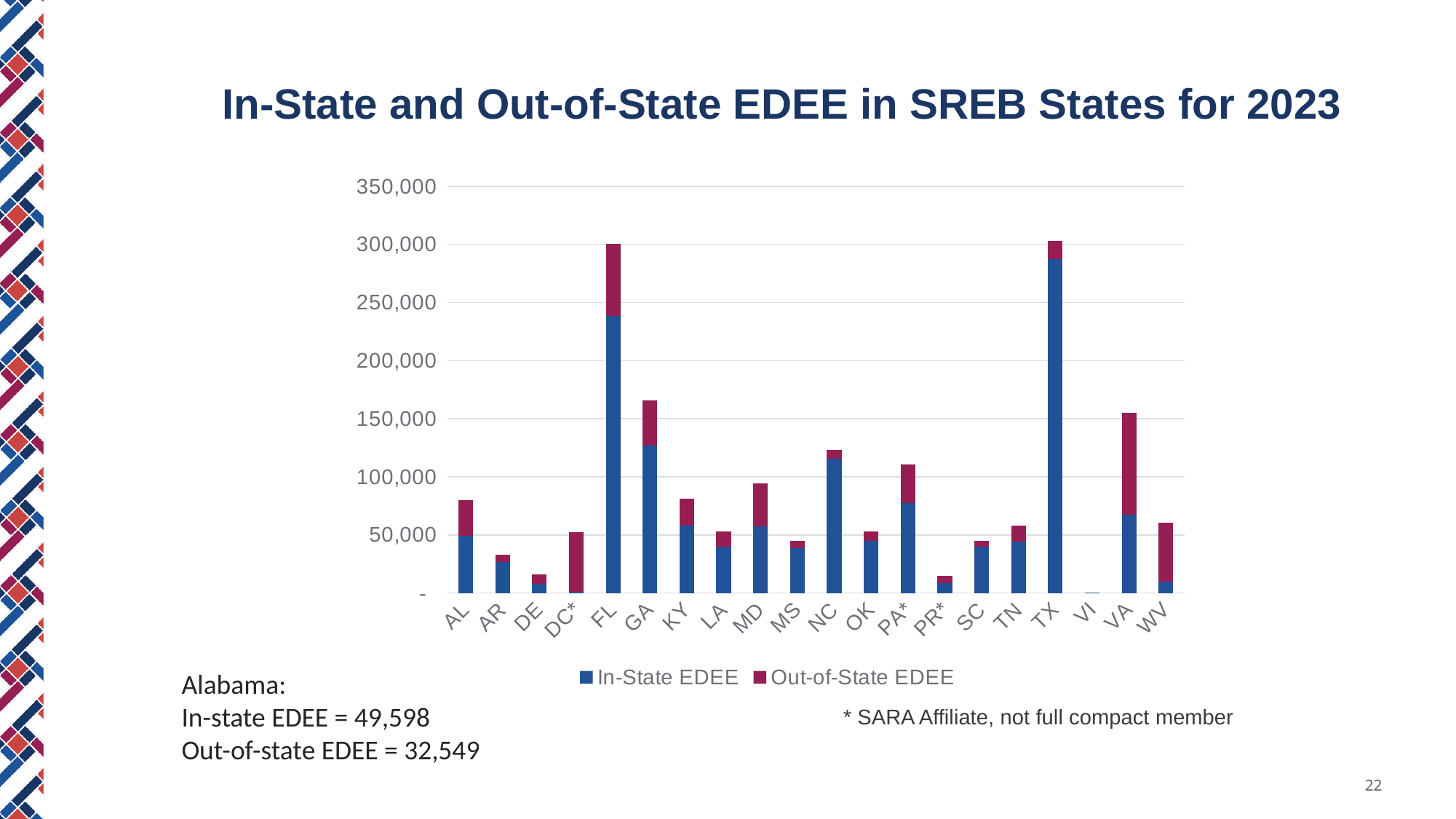
How many series does the chart's legend list? 2 How many states or jurisdictions are shown along the x axis of the chart? 20 What is the Out-of-state EDEE value for Alabama? 32,549 Is the In-State EDEE for VA greater or less than 100,000? less What is the total EDEE (in-state plus out-of-state) for Alabama? 82,147 Which state has the highest In-State EDEE? TX What kind of chart is shown on the slide? Stacked bar chart Which state or jurisdiction has the lowest total EDEE? VI Is the total EDEE for FL greater or less than 250,000? greater What is the In-state EDEE value for Alabama? 49,598 Which has the larger total EDEE, FL or GA? FL What does the asterisk after DC, PA and PR indicate, according to the note on the slide? SARA Affiliate, not full compact member